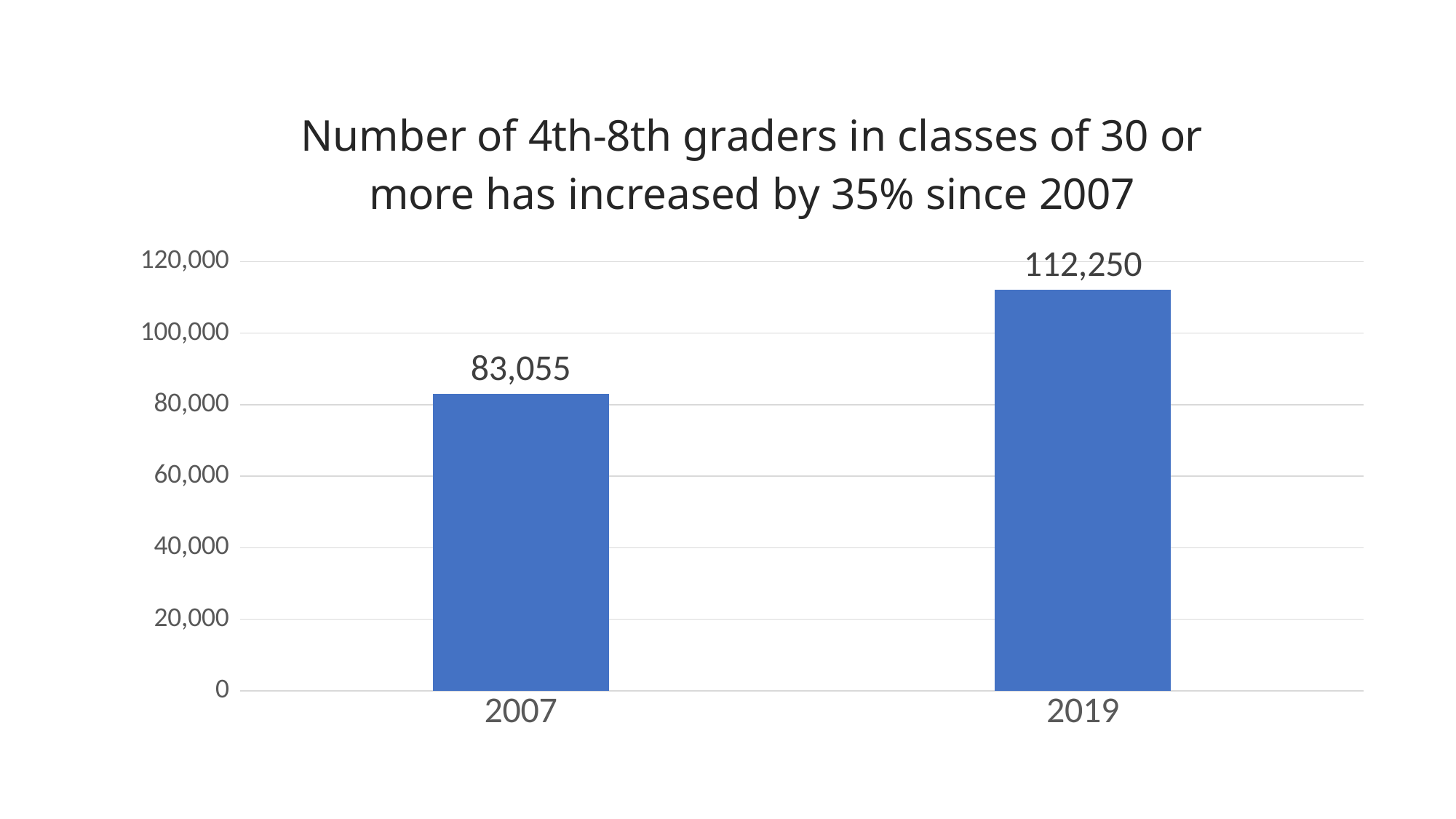
What is the title of the chart? Number of 4th-8th graders in classes of 30 or more has increased by 35% since 2007 How many bars are shown in the chart? 2 What is the value for 2007? 83,055 What is the value for 2019? 112,250 Which year has the highest value? 2019 What is the difference between the values for 2019 and 2007? 29,195 Which is larger, the value for 2007 or the value for 2019? 2019 Is the value for 2007 greater or less than 100,000? less Is the value for 2019 greater or less than 100,000? greater What kind of chart is shown on the slide? bar chart Do the values rise or fall from 2007 to 2019? rise Which year has the lowest value? 2007